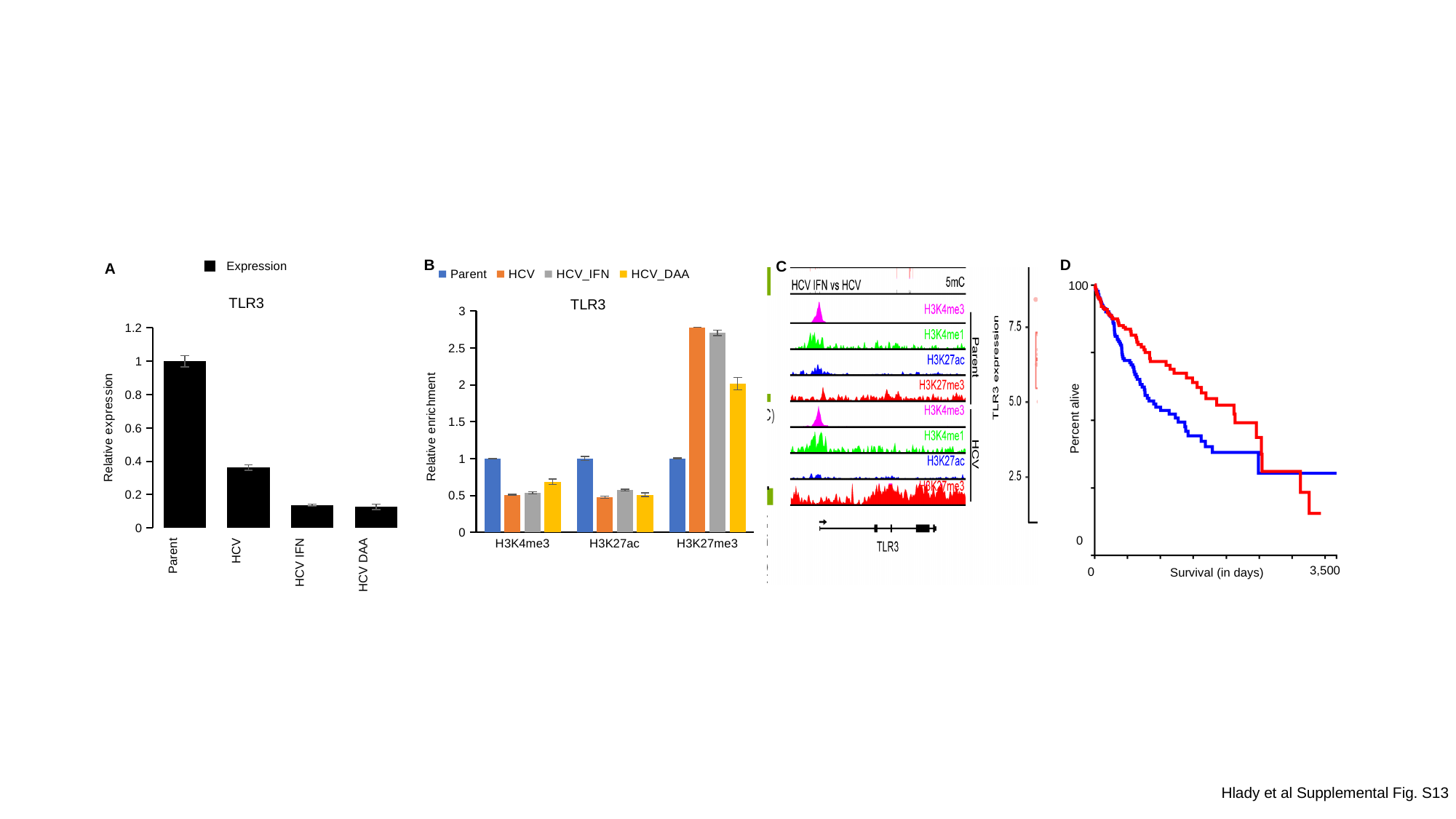
In chart B (TLR3 relative enrichment), what are the legend entries? Parent, HCV, HCV_IFN, HCV_DAA In chart B (TLR3 relative enrichment), how many series does the legend list? 4 In chart A (TLR3 relative expression), how many categories are plotted on the x axis? 4 In chart A (TLR3 relative expression), which is larger, the value for HCV or the value for HCV IFN? HCV In chart B (TLR3 relative enrichment), is the HCV_DAA value for H3K27me3 greater or less than 1.5? greater In chart A (TLR3 relative expression), what is the relative expression for Parent? 1 In chart D (survival curve), what is the x-axis label? Survival (in days) In chart B (TLR3 relative enrichment), how many categories are on the x axis? 3 In chart B (TLR3 relative enrichment), what is the relative enrichment of Parent for H3K4me3? 1 In chart A (TLR3 relative expression), what kind of chart is shown? bar chart In chart A (TLR3 relative expression), is the value for HCV greater or less than 0.6? less In chart A (TLR3 relative expression), which category has the highest relative expression? Parent